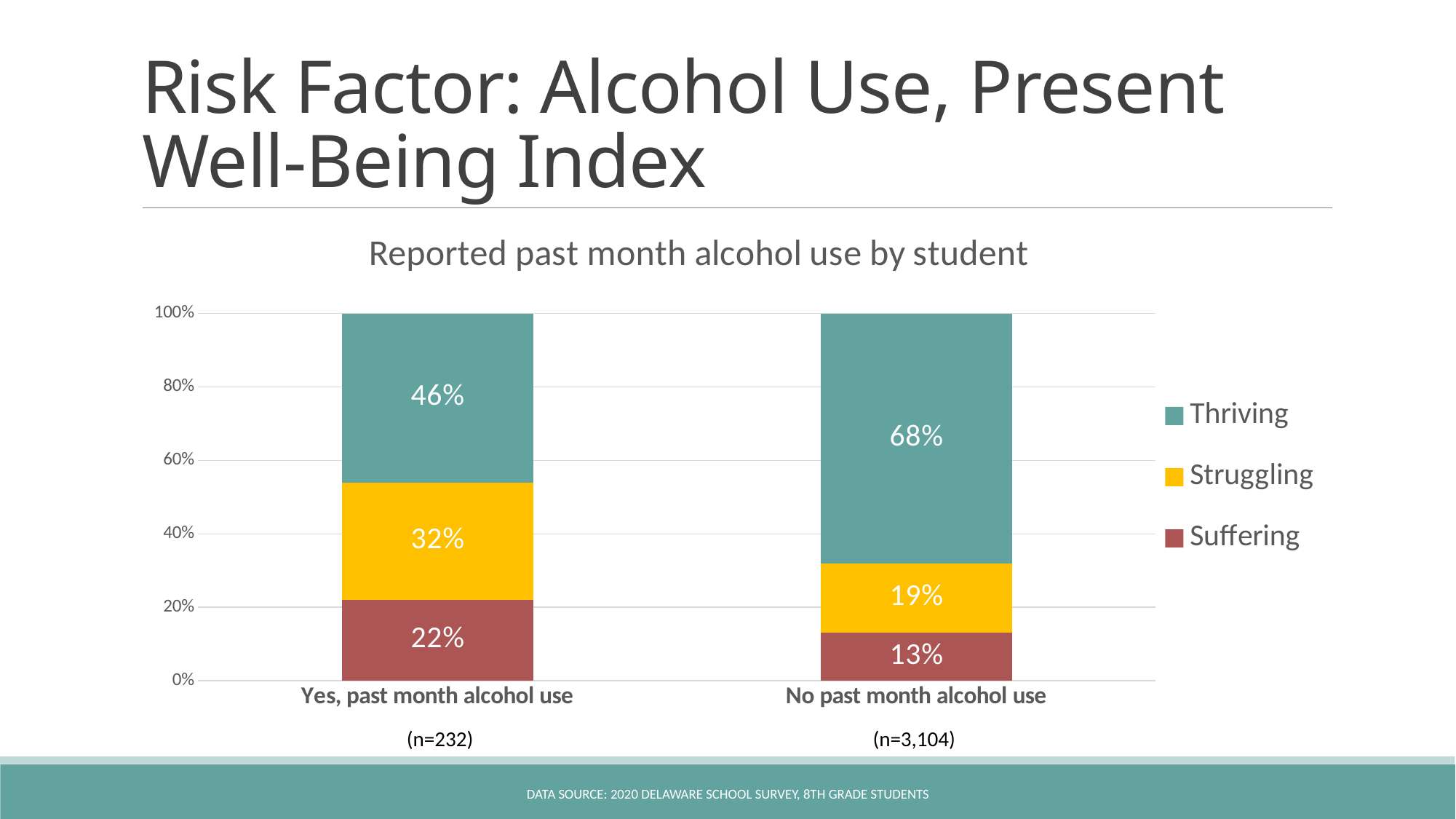
Which group has the higher Thriving percentage? No past month alcohol use What percentage of students with past month alcohol use are Thriving? 46% What is the Suffering value for the 'Yes, past month alcohol use' group? 22% How many categories are shown on the x axis? 2 What is the title of the chart? Reported past month alcohol use by student What is the Struggling value for the 'No past month alcohol use' group? 19% How many series does the legend list? 3 What is the difference in the Suffering percentage between the two groups? 9% What kind of chart is shown on the slide? Stacked bar chart Which group has the higher Struggling percentage? Yes, past month alcohol use What percentage of students with no past month alcohol use are Suffering? 13% What is the difference in the Thriving percentage between the 'No past month alcohol use' and 'Yes, past month alcohol use' groups? 22%